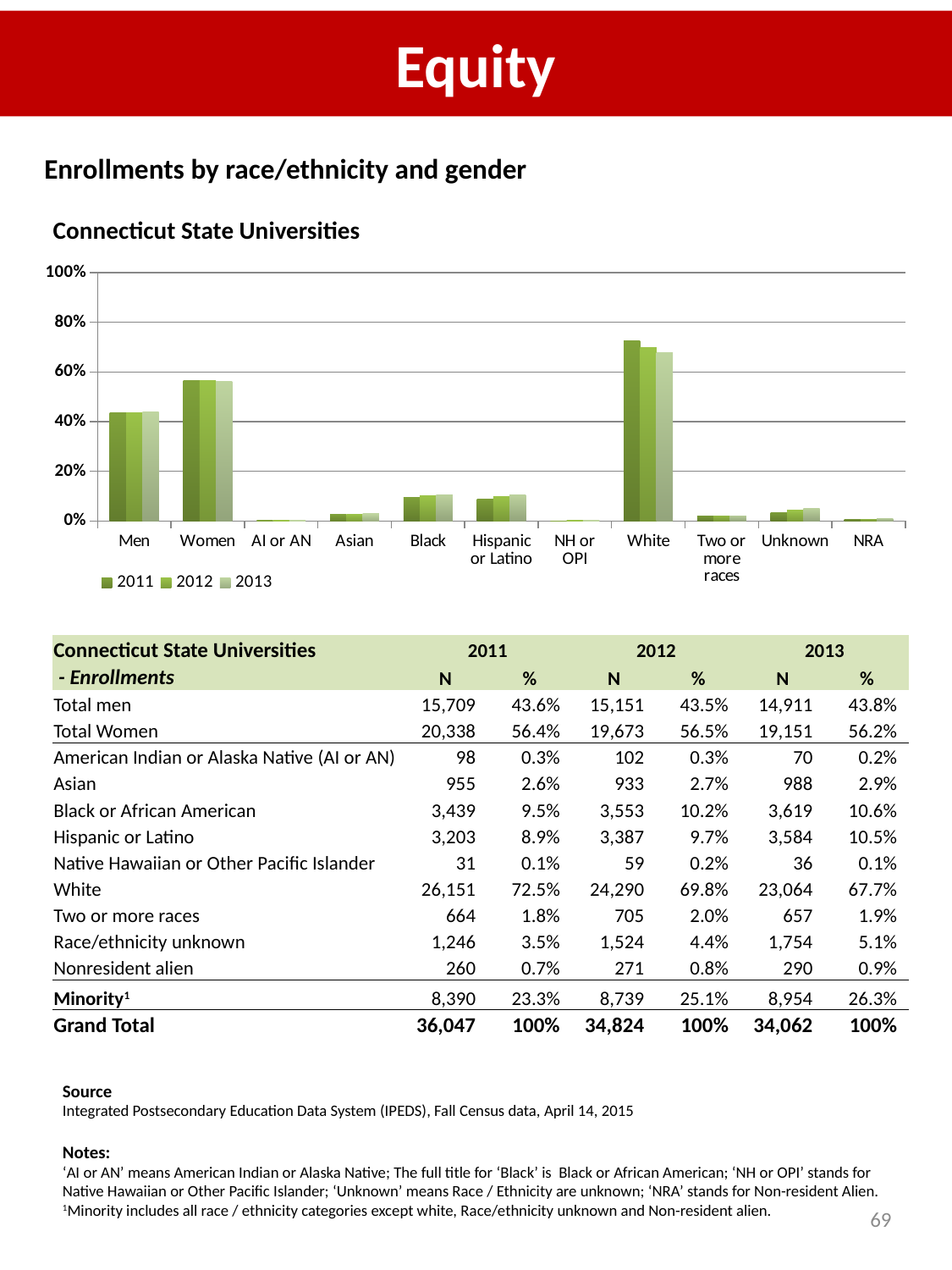
In 2012, which is larger, the value for Women or the value for Men? Women Which category has the highest bars in the chart? White What is the 2011 percentage for White, as printed in the table? 72.5% Is the 2013 value for Men greater or less than 60%? less Is the 2011 value for White greater or less than 60%? greater What is the title of the chart? Connecticut State Universities How many series does the chart legend list? 3 How many categories are shown along the x axis of the chart? 11 What is the 2013 percentage for Black or African American, as printed in the table? 10.6% Do the values for Hispanic or Latino rise or fall from 2011 to 2013? rise What kind of chart is shown on the slide? bar chart Do the values for White rise or fall from 2011 to 2013? fall